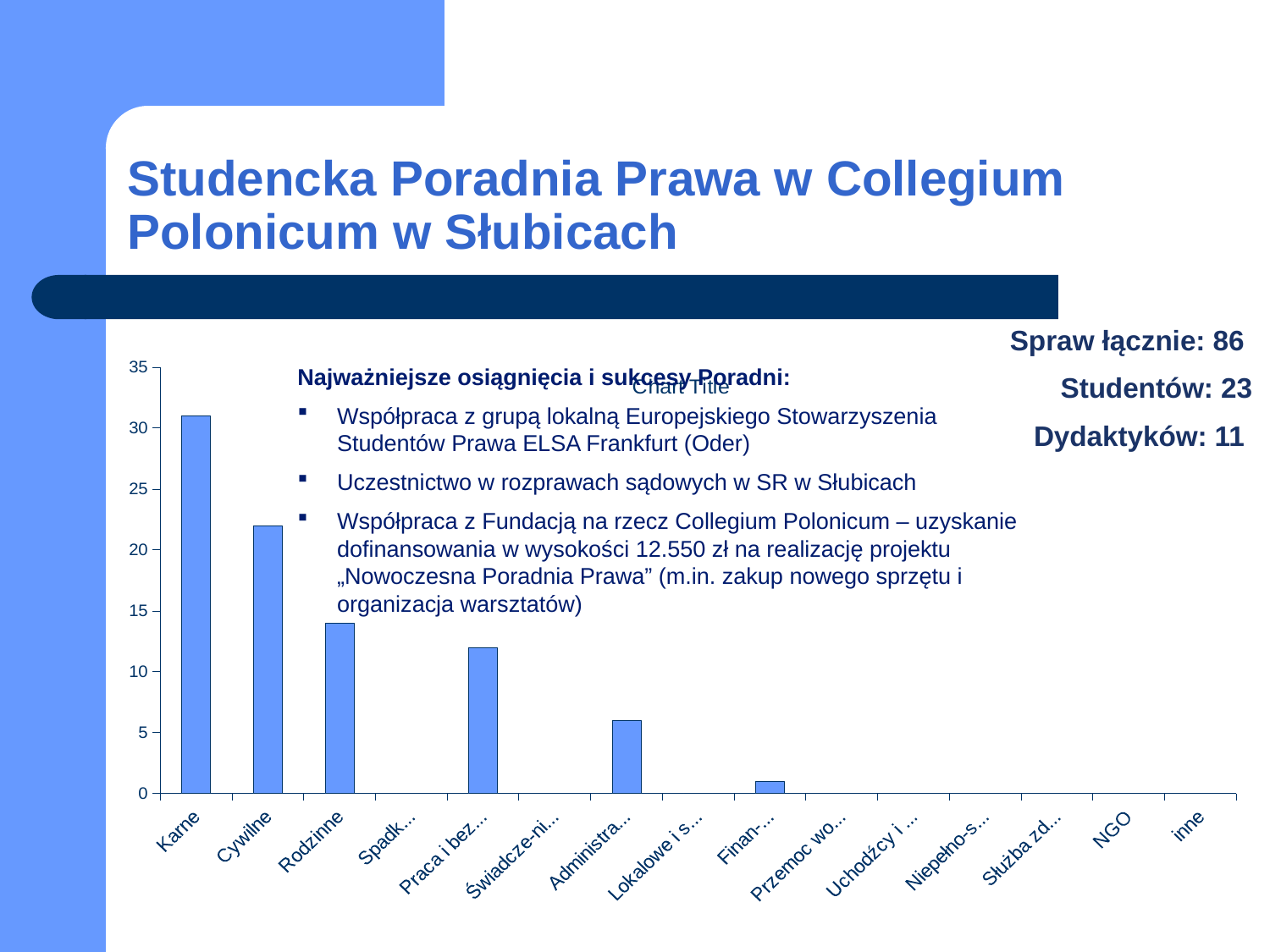
Which is larger, the value for Cywilne or the value for Rodzinne? Cywilne Is the value for Cywilne greater or less than 25? less Which is larger, the value for Karne or the value for Cywilne? Karne Is the value for Rodzinne greater or less than 10? greater What is the title shown on the chart? Chart Title Is the value for Cywilne greater or less than 20? greater How many categories are shown on the x axis of the chart? 15 What is the highest value shown on the vertical axis of the chart? 35 Which category has the highest bar in the chart? Karne What kind of chart is shown on the slide? bar chart